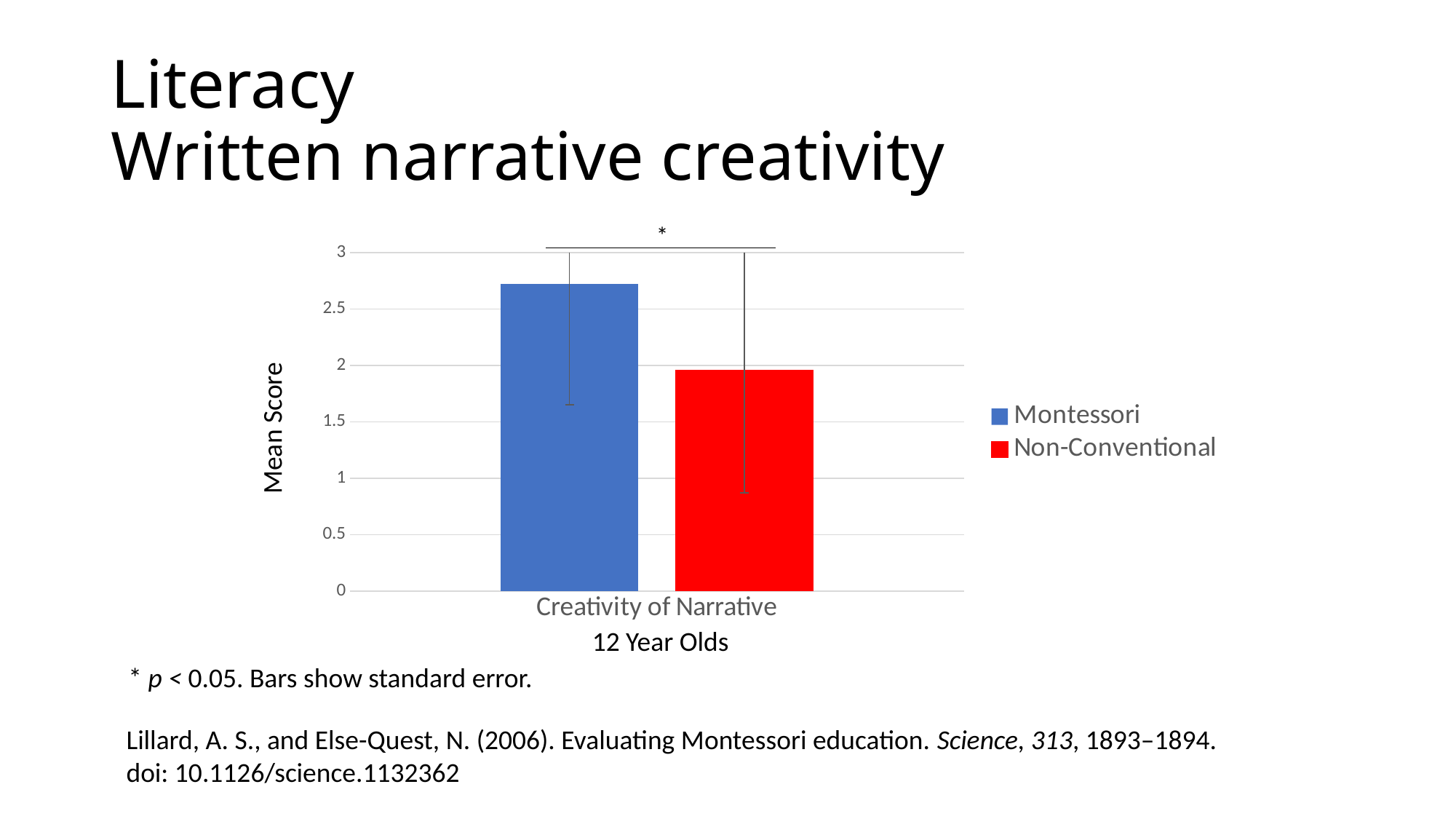
Which series has the higher mean score for Creativity of Narrative, Montessori or Non-Conventional? Montessori Which colour represents the Non-Conventional series in the chart? red Is the mean score for Non-Conventional greater or less than 1.5? greater Is the mean score for Montessori greater or less than 2.5? greater Which series has the lowest bar in the chart? Non-Conventional Which series has the highest bar in the chart? Montessori What kind of chart is shown on the slide? bar chart What is the label on the y axis of the chart? Mean Score How many categories are plotted on the x axis? 1 How many series does the legend list? 2 Is the mean score for Montessori greater or less than 3? less